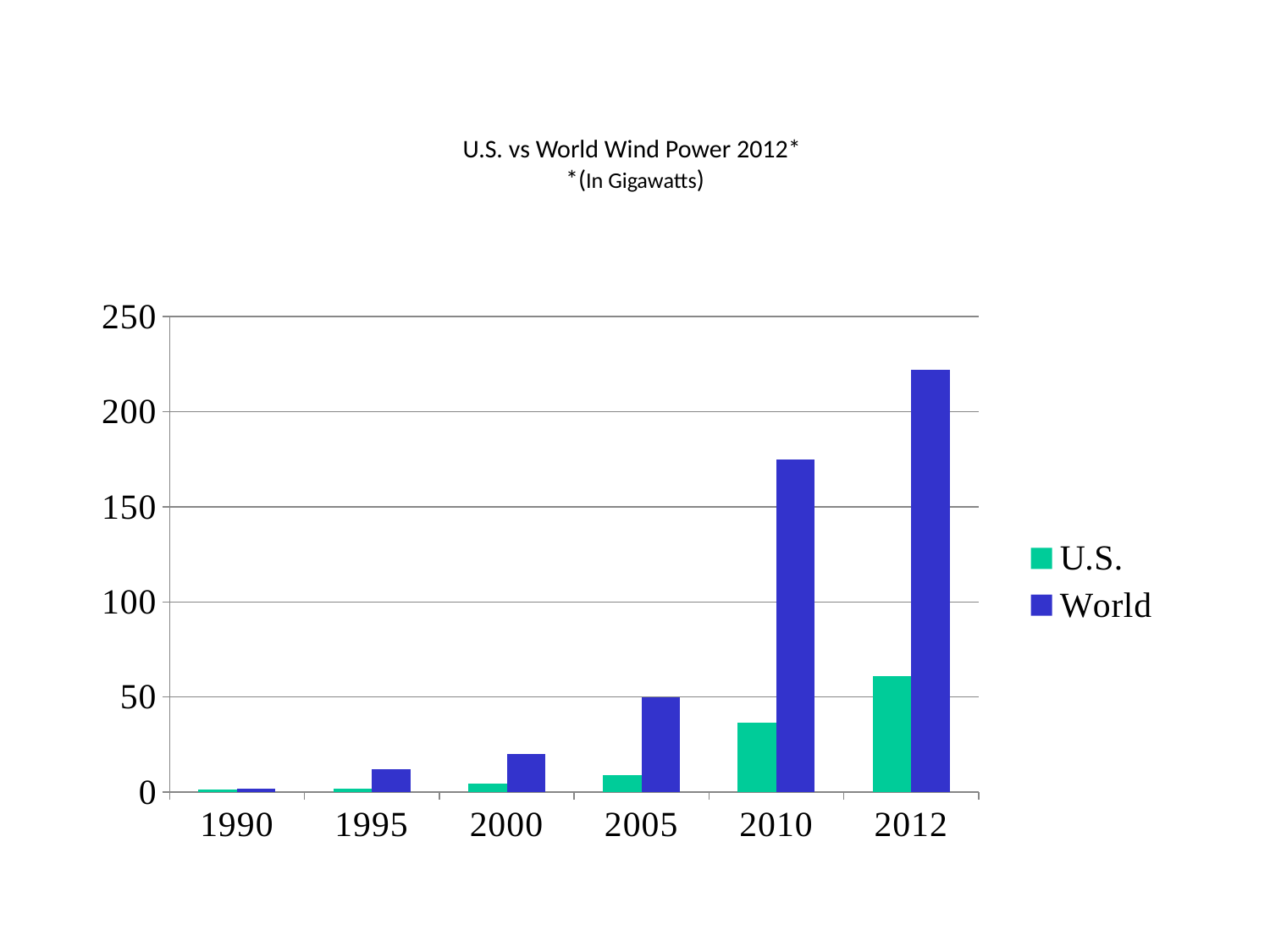
Is the World value for 2012 greater or less than 200? greater Is the U.S. value for 2010 greater or less than 50? less How many years are shown on the x axis? 6 Do the World values rise or fall from 1990 to 2012? rise Is the U.S. value for 2012 greater or less than 50? greater What kind of chart is shown on the slide? bar chart Which is larger in 2005, the U.S. value or the World value? World How many series does the legend list? 2 Which year has the highest World value? 2012 What unit does the chart title say the values are in? Gigawatts Which year has the lowest U.S. value? 1990